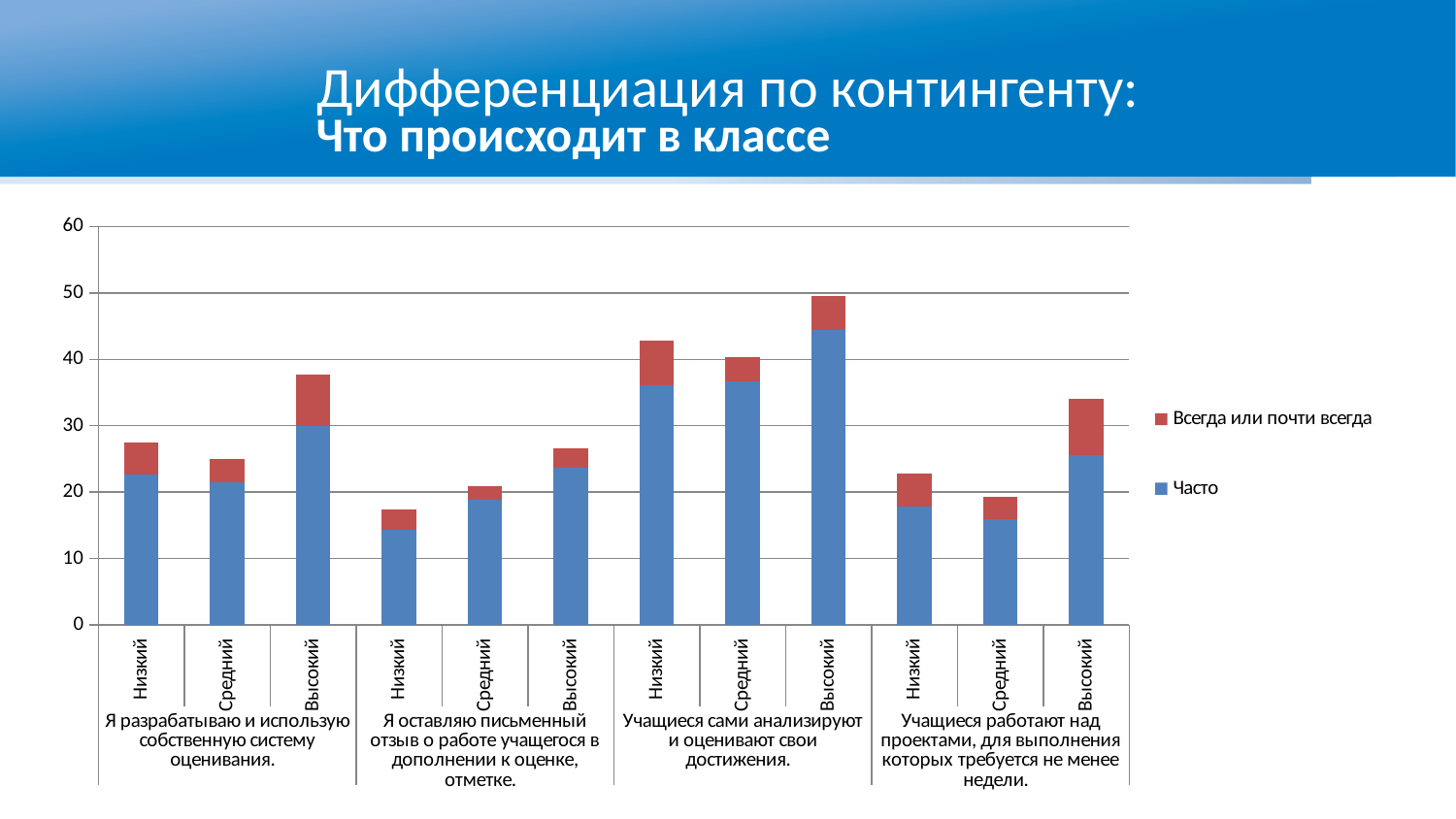
How many statement groups are shown along the x axis? 4 In the group "Учащиеся работают над проектами, для выполнения которых требуется не менее недели.", which category has the lowest total? Средний Is the total for Высокий in "Я разрабатываю и использую собственную систему оценивания." greater or less than 30? greater Is the total for Низкий in "Я оставляю письменный отзыв о работе учащегося в дополнении к оценке, отметке." greater or less than 20? less Is the total for Высокий in "Учащиеся сами анализируют и оценивают свои достижения." greater or less than 40? greater How many bars are plotted in the chart? 12 In the group "Учащиеся работают над проектами, для выполнения которых требуется не менее недели.", which bar is taller: Средний or Высокий? Высокий Which bar has the highest total in the chart? Высокий in "Учащиеся сами анализируют и оценивают свои достижения." In the group "Я оставляю письменный отзыв о работе учащегося в дополнении к оценке, отметке.", do the bar totals rise or fall from Низкий to Высокий? rise How many series does the legend list? 2 What kind of chart is shown on the slide? Stacked bar chart Which series is shown in blue at the bottom of each stacked bar? Часто